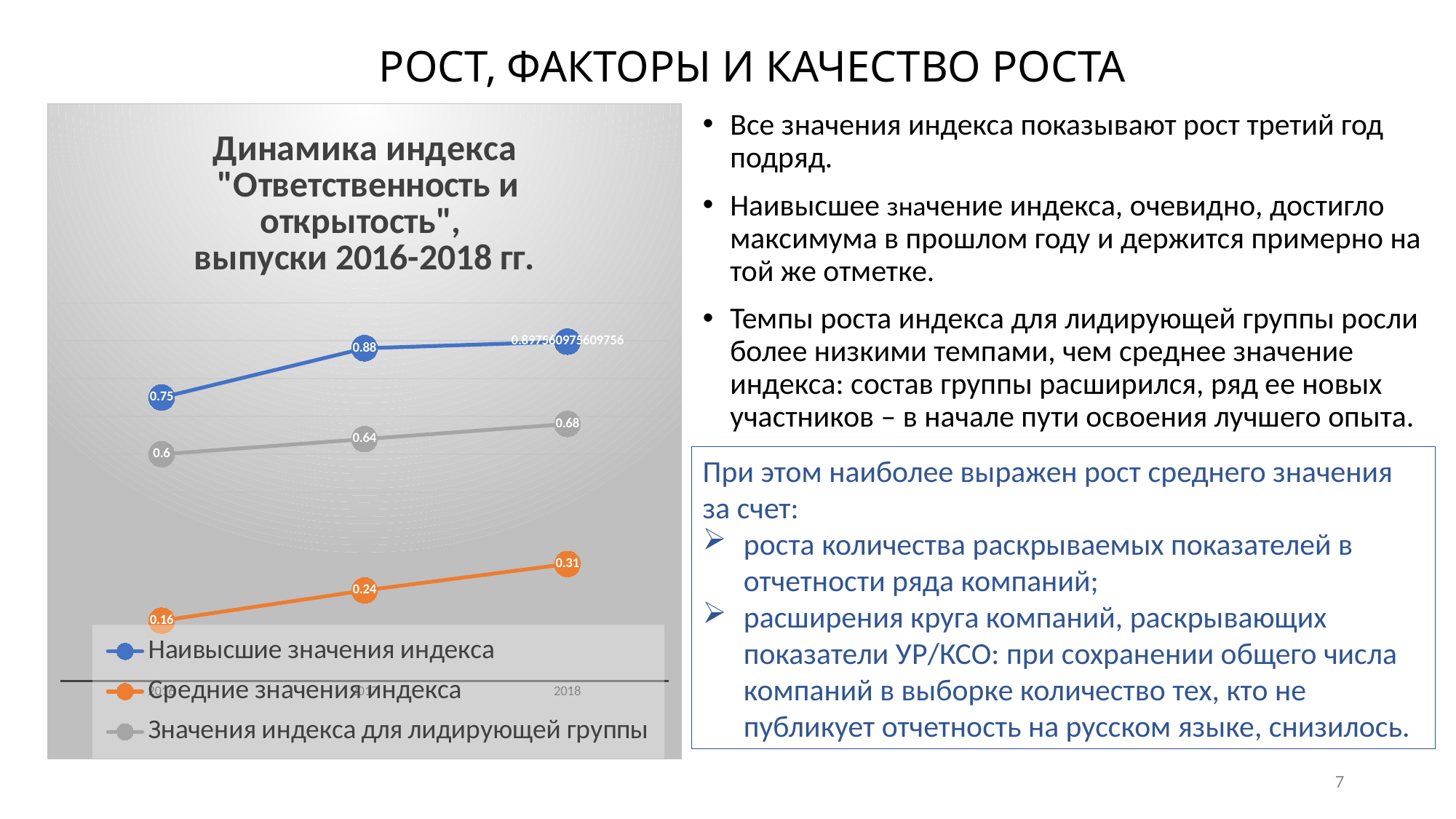
Do the values of "Средние значения индекса" rise or fall from 2016 to 2018? Rise What is the value of "Наивысшие значения индекса" for 2016? 0.75 In 2017, which is larger: "Наивысшие значения индекса" or "Значения индекса для лидирующей группы"? Наивысшие значения индекса What kind of chart is shown on the slide? Line chart What is the value of "Значения индекса для лидирующей группы" for 2017? 0.64 What is the lowest value plotted for "Средние значения индекса"? 0.16 What is the title of the chart? Динамика индекса "Ответственность и открытость", выпуски 2016-2018 гг. What is the value of "Средние значения индекса" for 2018? 0.31 How many series does the chart legend list? 3 Which series has the highest value in 2018? Наивысшие значения индекса How many data points does each series in the chart have? 3 What is the difference between the 2018 and 2016 values of "Средние значения индекса"? 0.15